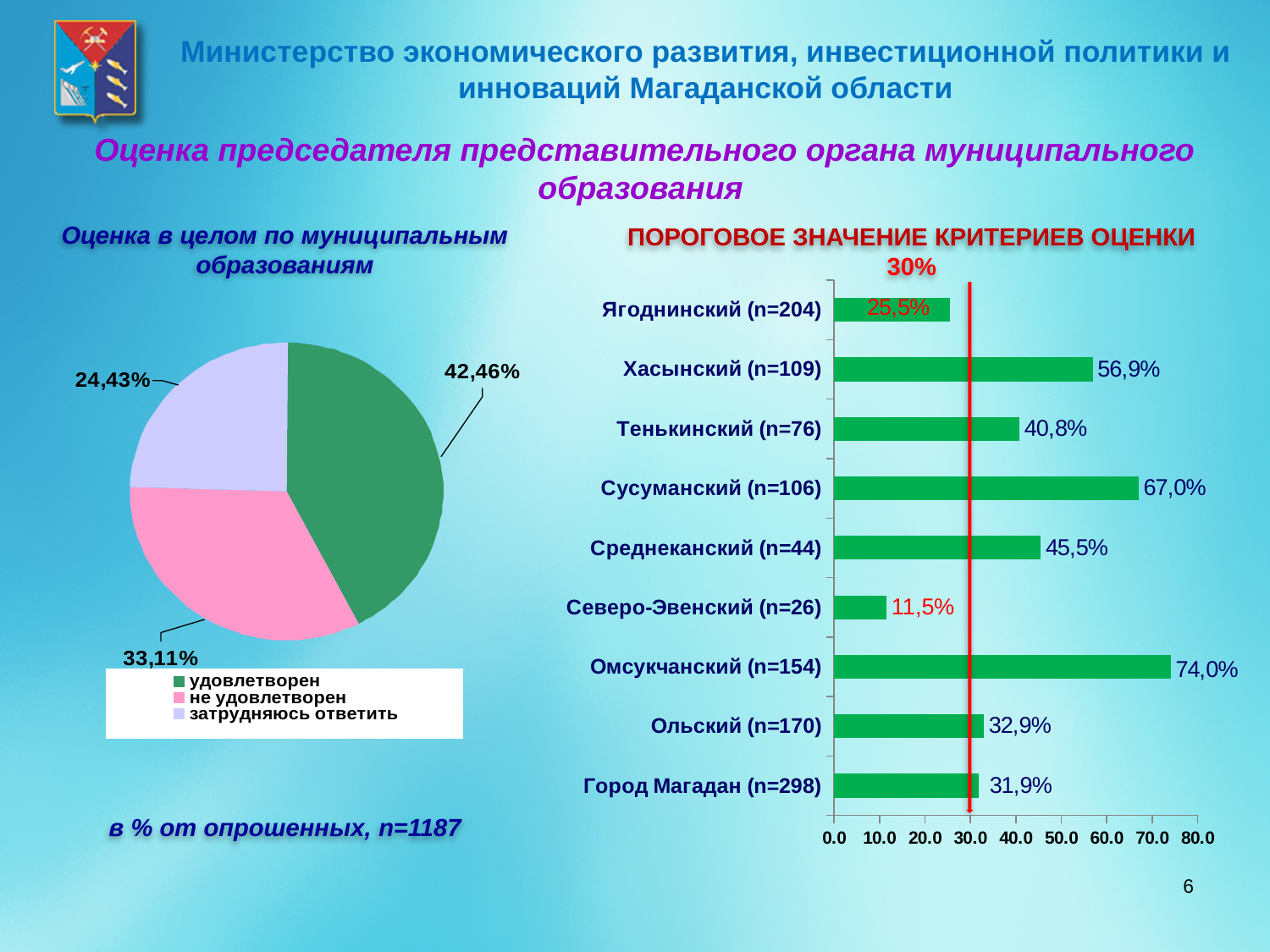
In the bar chart on the right, what is the value for Омсукчанский (n=154)? 74,0% In the pie chart on the left, what share of respondents answered "затрудняюсь ответить"? 24,43% How many municipalities are shown in the bar chart on the right? 9 In the bar chart on the right, which municipality has the lowest value? Северо-Эвенский (n=26) In the bar chart on the right, what is the value for Город Магадан (n=298)? 31,9% What type of chart is the chart on the right of the slide? bar chart In the bar chart on the right, which is larger: the value for Хасынский (n=109) or Тенькинский (n=76)? Хасынский (n=109) In the pie chart on the left, what is the difference between the "удовлетворен" and "не удовлетворен" shares? 9,35% In the pie chart on the left, what share of respondents answered "удовлетворен"? 42,46% In the bar chart on the right, which municipality has the highest value? Омсукчанский (n=154) How many entries does the legend of the pie chart on the left list? 3 In the pie chart on the left, which answer has the smallest share? затрудняюсь ответить